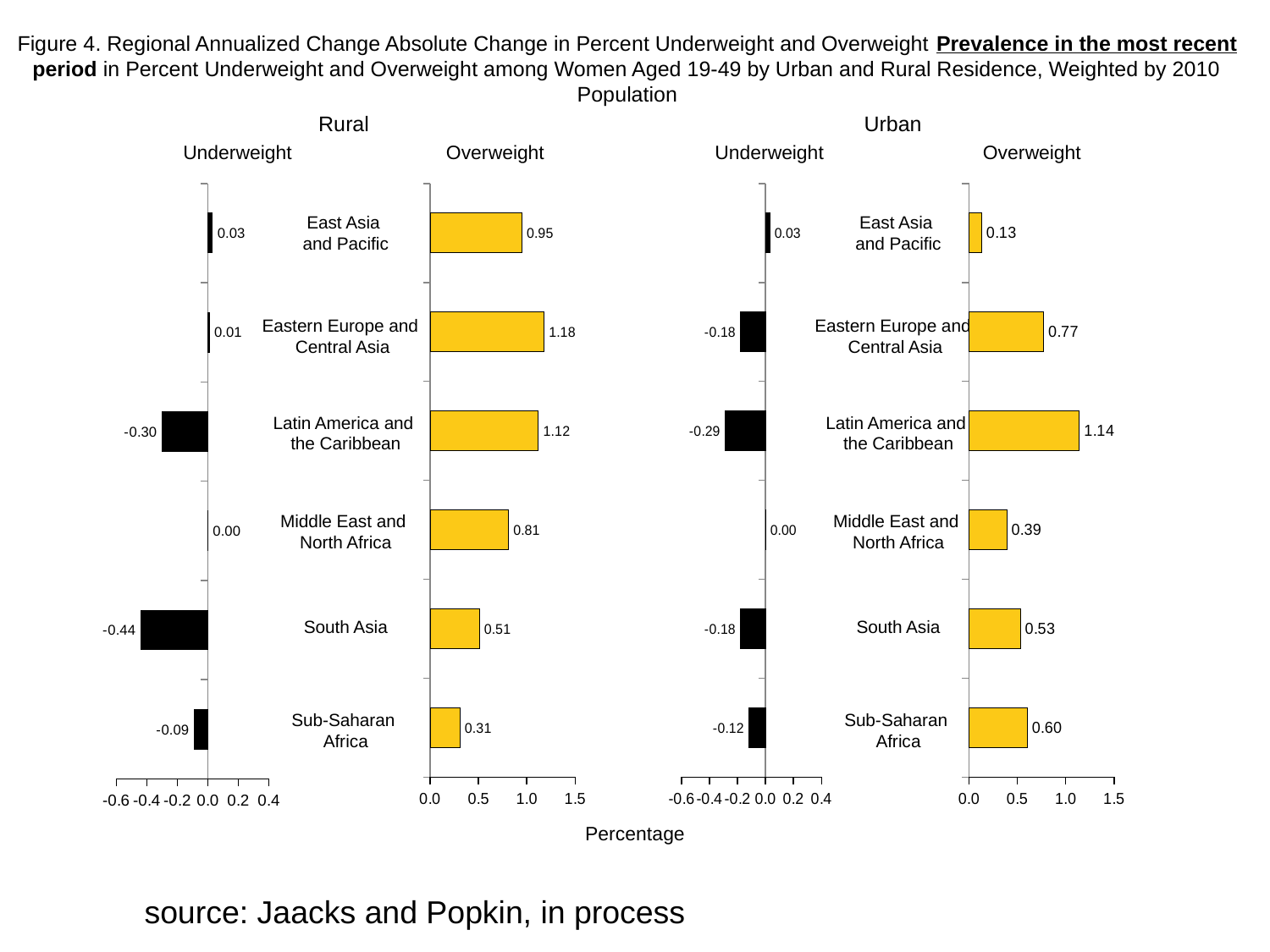
In the Urban Overweight chart, which region has the lowest value? East Asia and Pacific In the Urban Underweight chart, what is the value for Latin America and the Caribbean? -0.29 How many regions are shown in the Rural Underweight chart? 6 In the Urban Overweight chart, what is the difference between Latin America and the Caribbean and Middle East and North Africa? 0.75 What kind of chart is the Urban Overweight chart? Bar chart In the Urban Overweight chart, what is the value for Sub-Saharan Africa? 0.60 In the Rural Overweight chart, what is the difference between East Asia and Pacific and South Asia? 0.44 In the Rural Underweight chart, which region has the lowest value? South Asia In the Rural Overweight chart, is the value for Latin America and the Caribbean greater or less than 1.0? greater In the Urban Overweight chart, which is larger: the value for South Asia or the value for Middle East and North Africa? South Asia In the Rural Overweight chart, which region has the highest value? Eastern Europe and Central Asia In the Rural Overweight chart, what is the value for Eastern Europe and Central Asia? 1.18